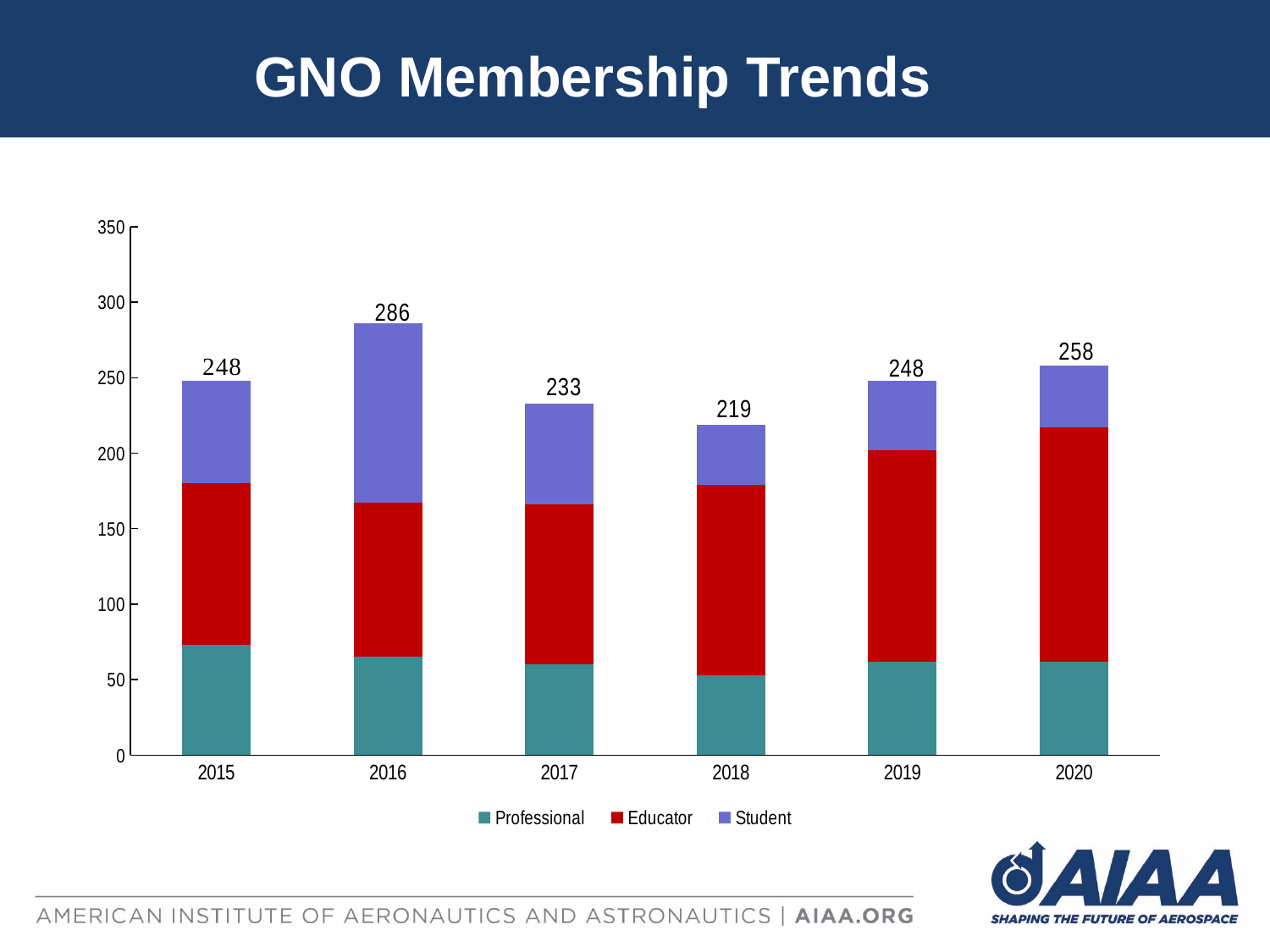
Which year has a larger total membership, 2017 or 2020? 2020 What is the total membership shown for 2020? 258 What kind of chart is shown on the slide? Stacked bar chart Which year has the highest total membership? 2016 Do the total membership values rise or fall from 2018 to 2020? Rise Is the Professional segment for 2015 greater or less than 50? greater What is the total membership shown for 2018? 219 How many years are shown on the x axis? 6 What is the total membership shown for 2016? 286 Which year has the lowest total membership? 2018 How many series does the legend list? 3 What is the difference between the total membership in 2016 and in 2018? 67